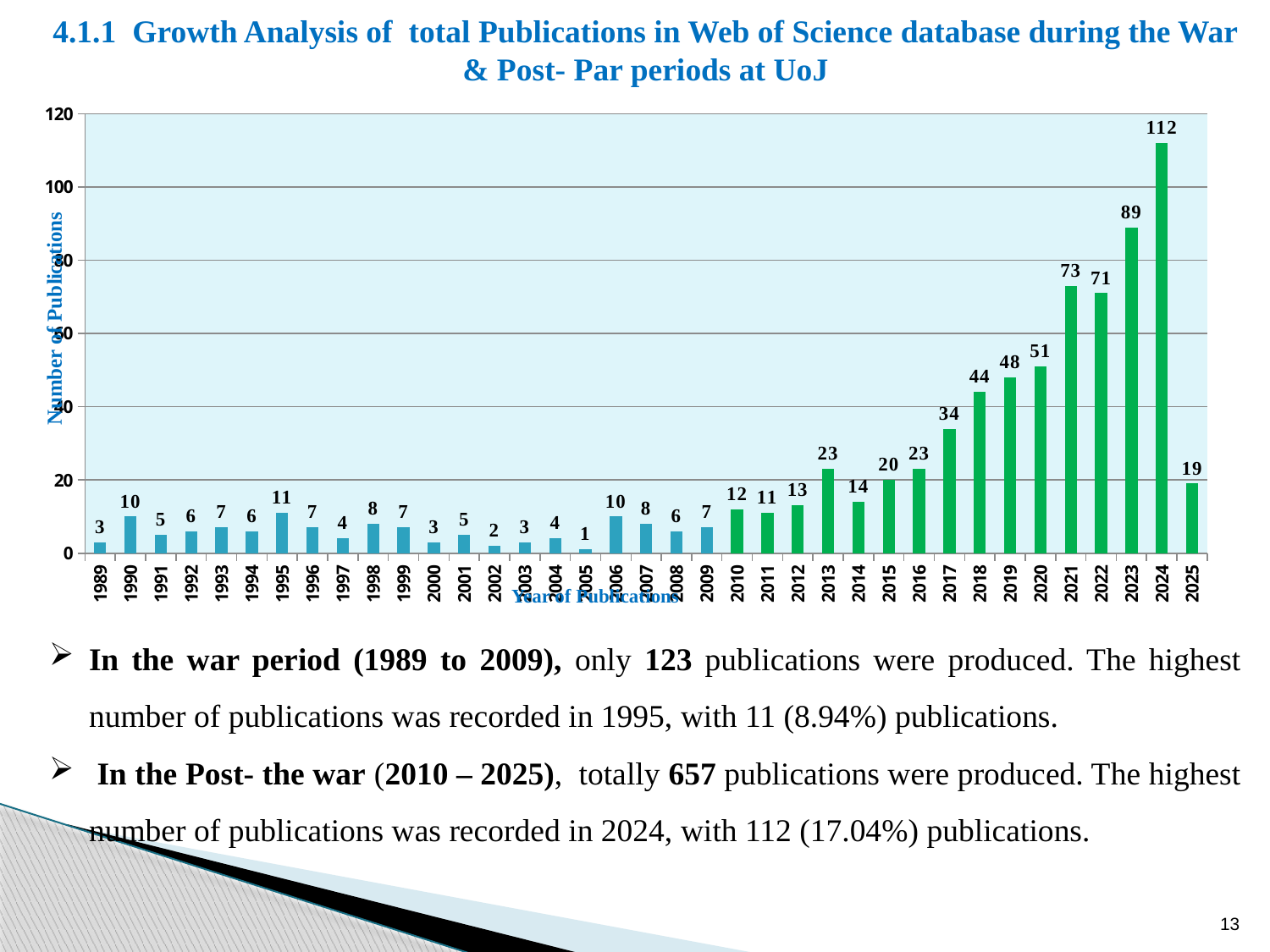
Which year has the highest number of publications? 2024 What kind of chart is shown on the slide? Bar chart What is the number of publications for 2017? 34 Is the value for 2023 greater or less than 80? greater How many years are shown on the x axis of the chart? 37 What is the difference in publications between 2024 and 2023? 23 Which year has the lowest number of publications? 2005 What is the number of publications for 1995? 11 What is the number of publications for 2024? 112 Which year has more publications, 2021 or 2022? 2021 Do the values generally rise or fall from 2010 to 2024? Rise What is the label of the y axis of the chart? Number of Publications